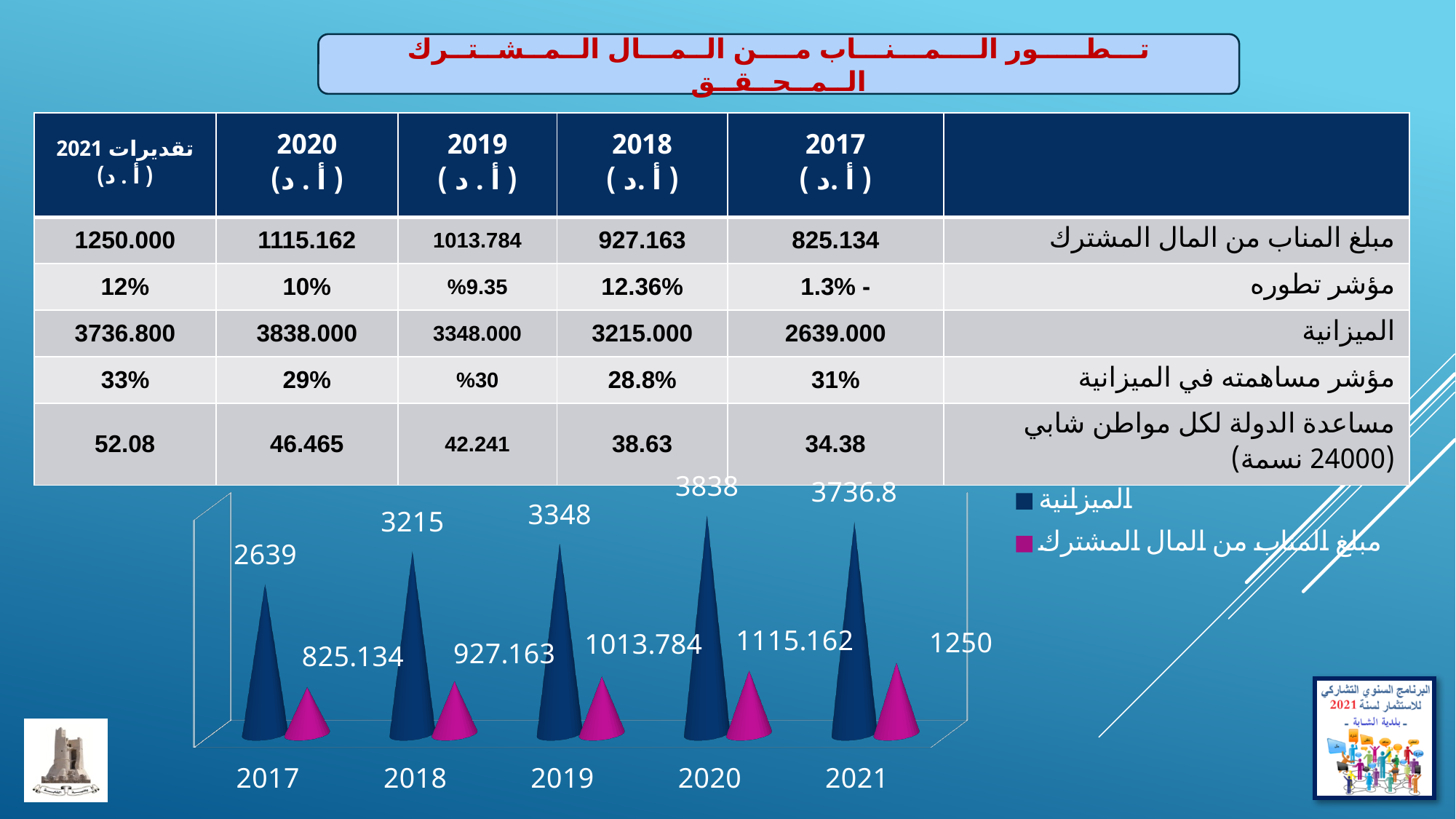
What is the value of the الميزانية (dark blue) series for 2020 in the chart? 3838 In which year is the الميزانية (dark blue) series highest in the chart? 2020 What is the difference between the الميزانية values for 2020 and 2021 in the chart? 101.2 In which year is the الميزانية (dark blue) series lowest in the chart? 2017 How many series does the chart legend list? 2 What is the value of the مبلغ المناب من المال المشترك (magenta) series for 2019 in the chart? 1013.784 How many years are plotted on the x axis of the chart? 5 What type of chart is shown at the bottom of the slide? bar chart In which year is the مبلغ المناب من المال المشترك (magenta) series highest in the chart? 2021 Which is larger in the chart: the الميزانية value for 2018 or for 2019? 2019 What is the value of the الميزانية (dark blue) series for 2021 in the chart? 3736.8 Does the مبلغ المناب من المال المشترك (magenta) series rise or fall from 2017 to 2021 in the chart? rise